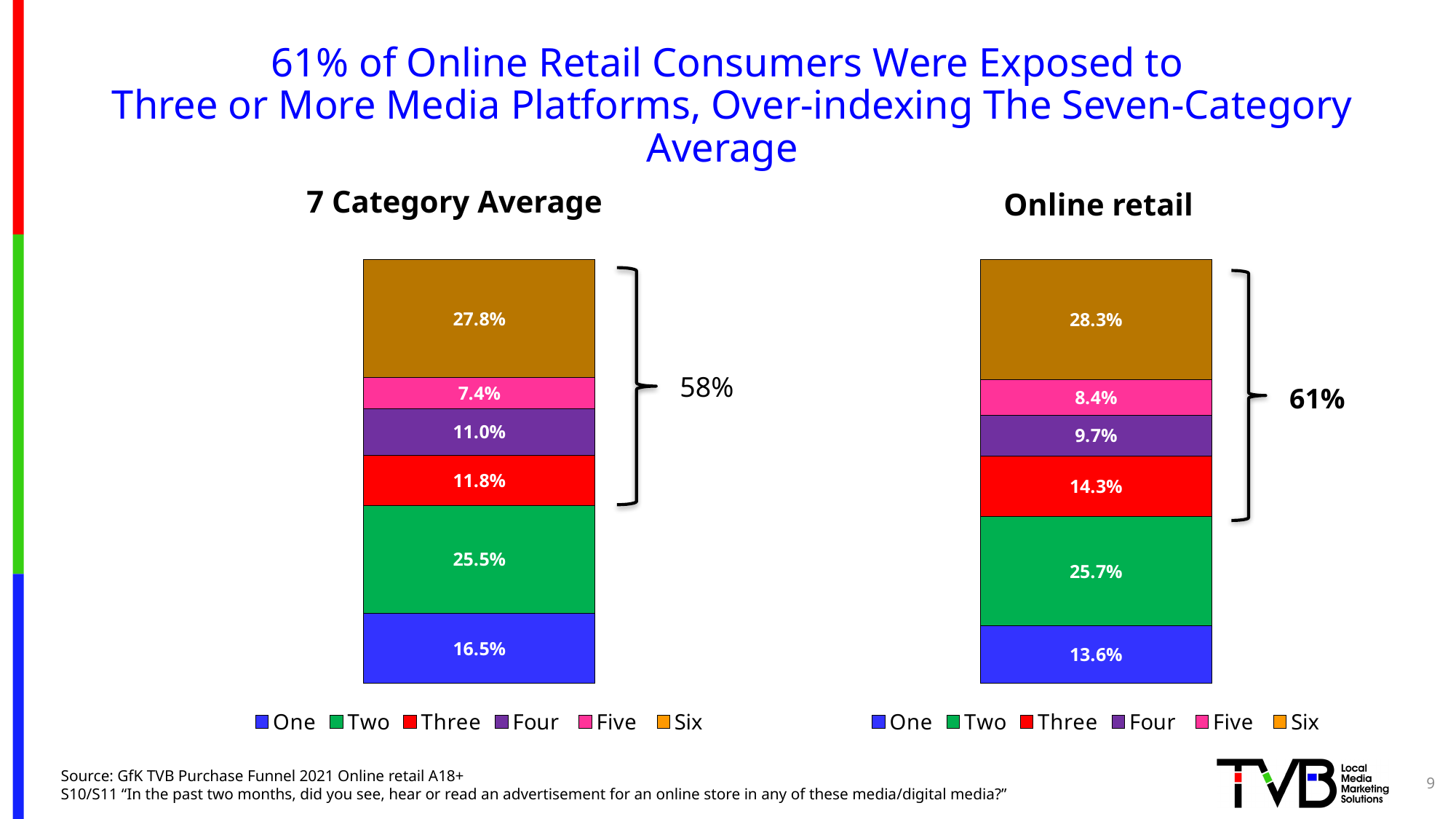
How many series does the legend of the 7 Category Average chart list? 6 In the 7 Category Average chart, what is the value for the Six segment? 27.8% What percentage is shown by the bracket next to the Online retail chart? 61% In the 7 Category Average chart, which segment has the smallest value? Five In the Online retail chart, what is the value for the One segment? 13.6% Which is larger: the One segment in the 7 Category Average chart or the One segment in the Online retail chart? 7 Category Average How many segments make up the stacked bar in the Online retail chart? 6 What kind of chart is the Online retail chart? Stacked bar chart In the 7 Category Average chart, what is the value for the Five segment? 7.4% In the Online retail chart, which segment has the largest value? Six What is the difference between the Three segment in the Online retail chart and the Three segment in the 7 Category Average chart? 2.5% In the Online retail chart, what is the value for the Three segment? 14.3%